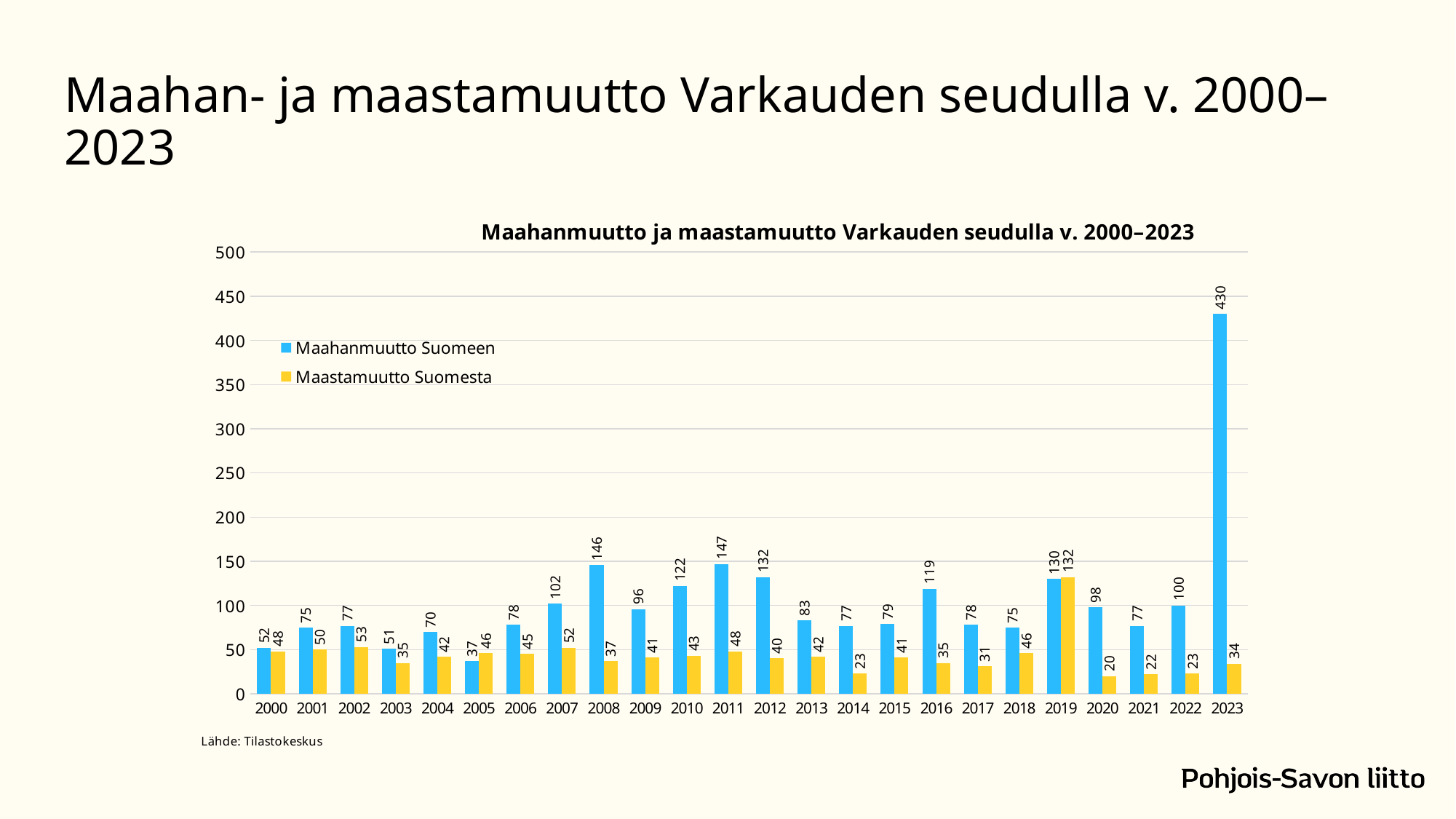
How many series does the legend list? 2 What is the value of Maahanmuutto Suomeen in 2023? 430 Which year has the lowest value for Maahanmuutto Suomeen? 2005 How many years are shown on the x axis? 24 What is the value of Maahanmuutto Suomeen in 2011? 147 Which year has the highest value for Maahanmuutto Suomeen? 2023 Which is larger in 2005, Maahanmuutto Suomeen or Maastamuutto Suomesta? Maastamuutto Suomesta What is the value of Maastamuutto Suomesta in 2019? 132 What kind of chart is shown on the slide? Bar chart What is the title of the chart? Maahanmuutto ja maastamuutto Varkauden seudulla v. 2000–2023 Which year has the lowest value for Maastamuutto Suomesta? 2020 What is the difference between Maahanmuutto Suomeen and Maastamuutto Suomesta in 2023? 396